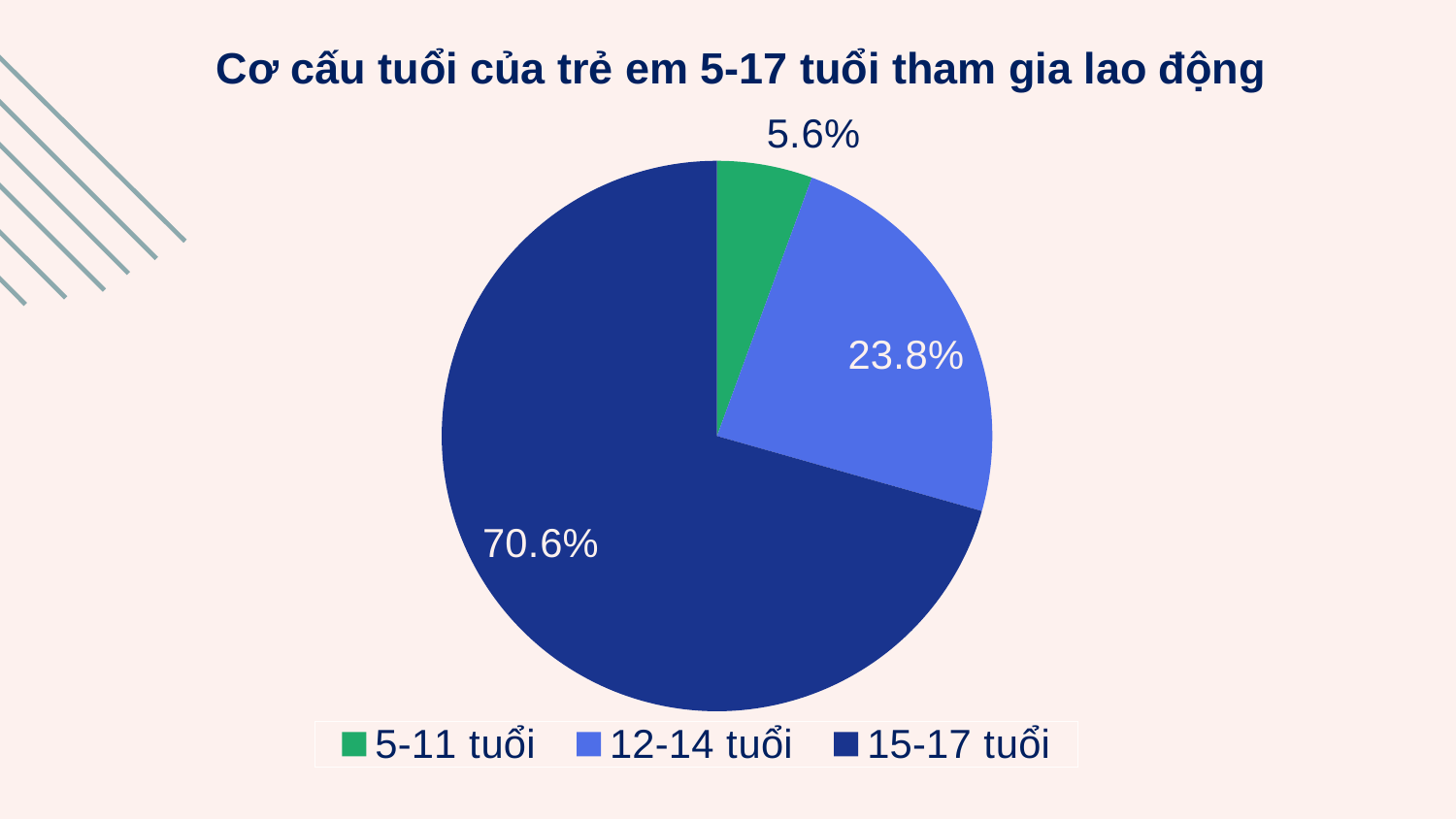
What is the title of the chart? Cơ cấu tuổi của trẻ em 5-17 tuổi tham gia lao động What is the value shown for the 12-14 tuổi slice? 23.8% How many slices does the pie chart have? 3 Which is larger, the share for 12-14 tuổi or the share for 5-11 tuổi? 12-14 tuổi What is the difference between the shares of 15-17 tuổi and 12-14 tuổi? 46.8% What is the difference between the shares of 12-14 tuổi and 5-11 tuổi? 18.2% What share of the pie does the 15-17 tuổi slice represent? 70.6% Which age group has the smallest share of the pie? 5-11 tuổi What is the value shown for the 5-11 tuổi slice? 5.6% Which colour represents the 5-11 tuổi group in the legend? Green What kind of chart is shown on the slide? Pie chart Which age group has the largest share of the pie? 15-17 tuổi